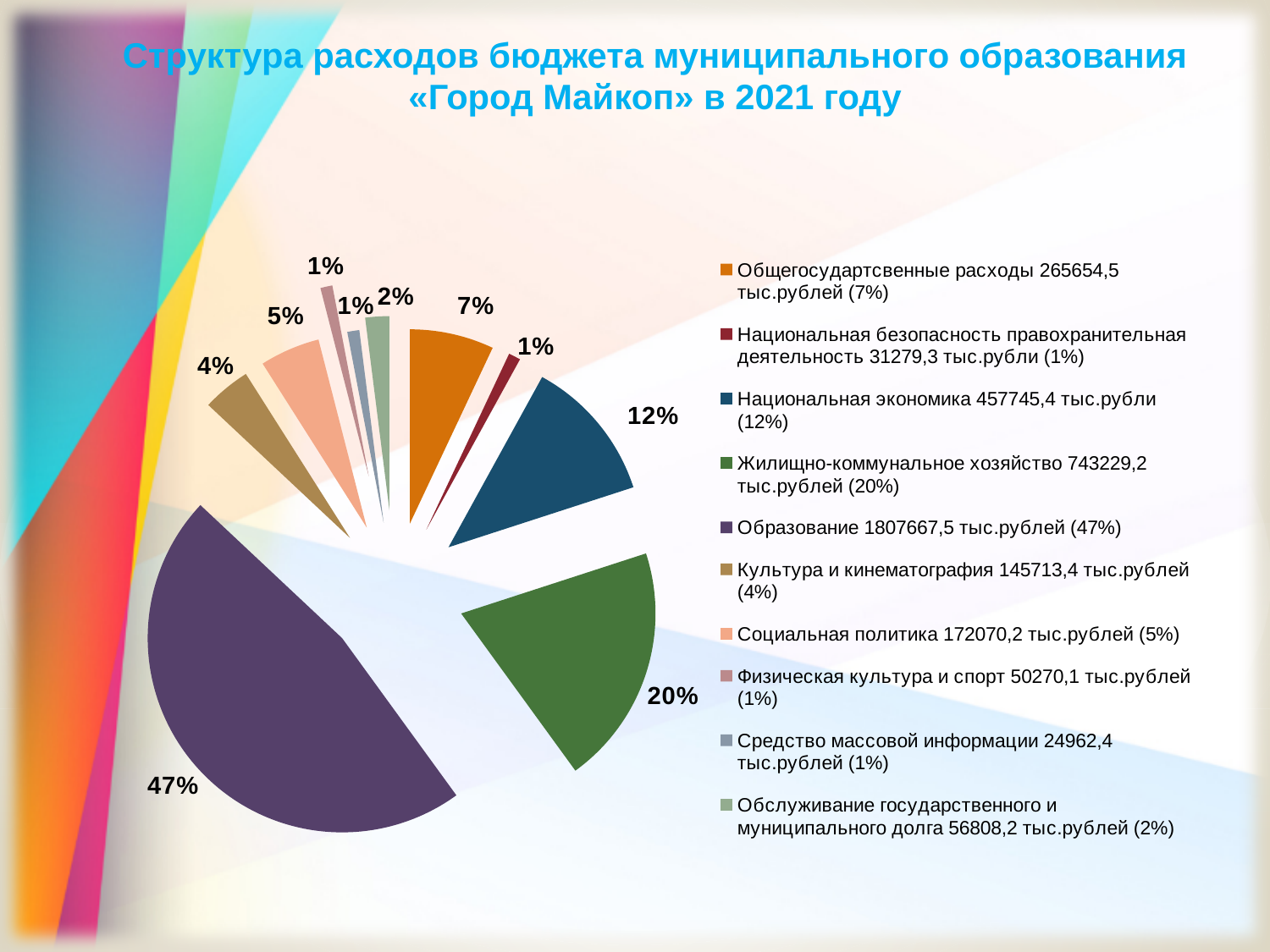
Which category has the largest share of the pie chart? Образование What share of the pie does Образование account for? 47% What kind of chart is shown on the slide? Pie chart What is the title of the slide? Структура расходов бюджета муниципального образования «Город Майкоп» в 2021 году What is the difference in percentage points between the shares of Образование and Жилищно-коммунальное хозяйство? 27 Which has a larger share: Общегосударственные расходы or Культура и кинематография? Общегосударственные расходы What is the value shown in the legend for Национальная экономика? 457745,4 тыс.рубли How many slices does the pie chart have? 10 What share of the pie does Жилищно-коммунальное хозяйство account for? 20% What is the value shown in the legend for Социальная политика? 172070,2 тыс.рублей What share of the pie does Обслуживание государственного и муниципального долга account for? 2% Which category has the smallest value according to the legend? Средство массовой информации